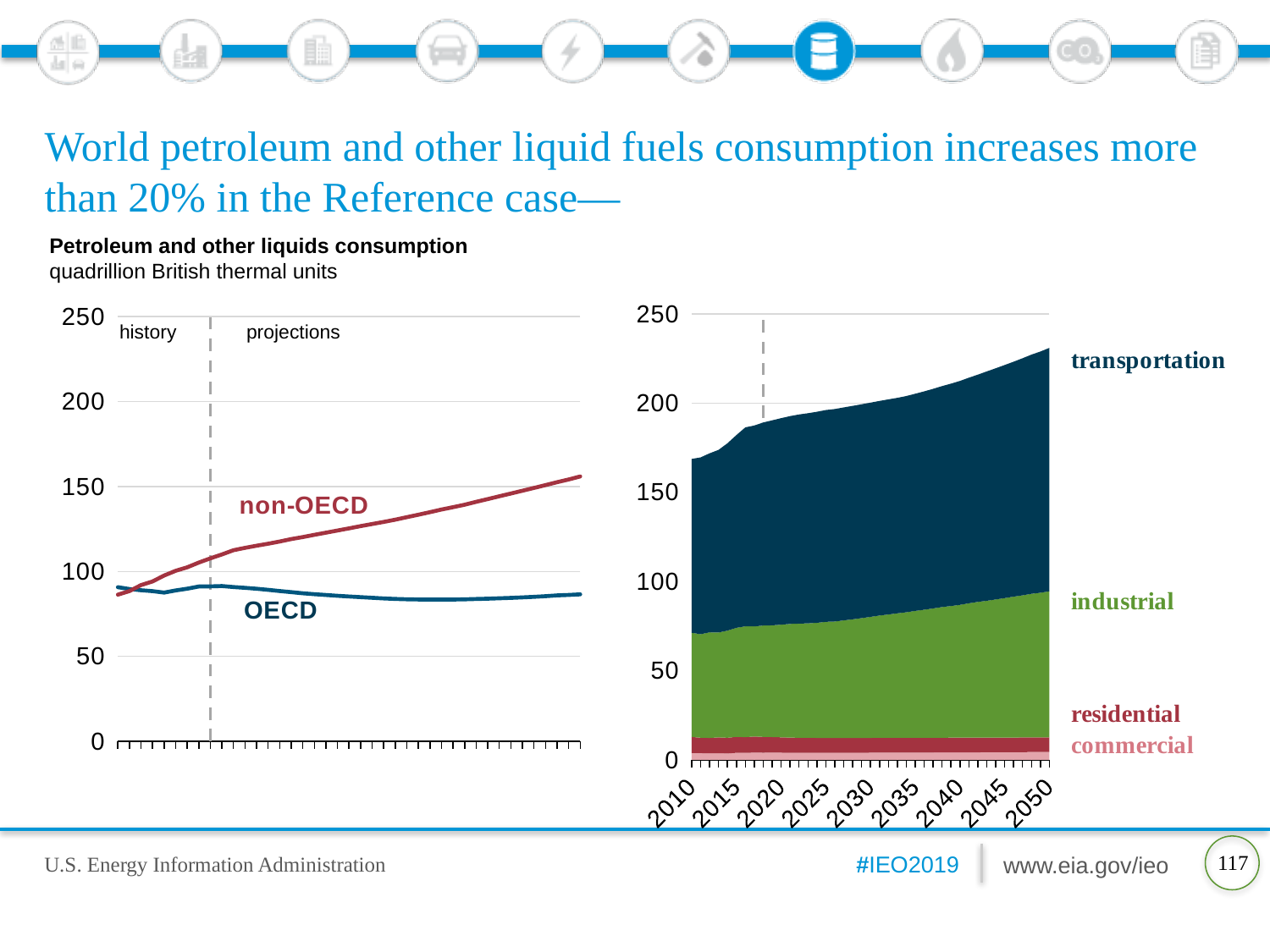
How many series are plotted on the left chart? 2 On the left chart, does non-OECD consumption rise or fall over the projection period? rise On the left chart, is the OECD value at the end of the projection period greater or less than 100? less What type of chart is the left chart showing OECD and non-OECD consumption? line chart What type of chart is the right chart showing consumption by sector? stacked area chart How many sectors are shown on the right chart? 4 On the left chart, which series is higher at the end of the projection period, OECD or non-OECD? non-OECD On the right chart, which sector accounts for the smallest share of consumption? commercial What unit of measurement is used for the charts on this slide? quadrillion British thermal units On the right chart, which sector accounts for the largest share of consumption? transportation On the right chart, is total consumption in 2050 greater or less than 200? greater On the left chart, is the non-OECD value at the end of the projection period greater or less than 150? greater